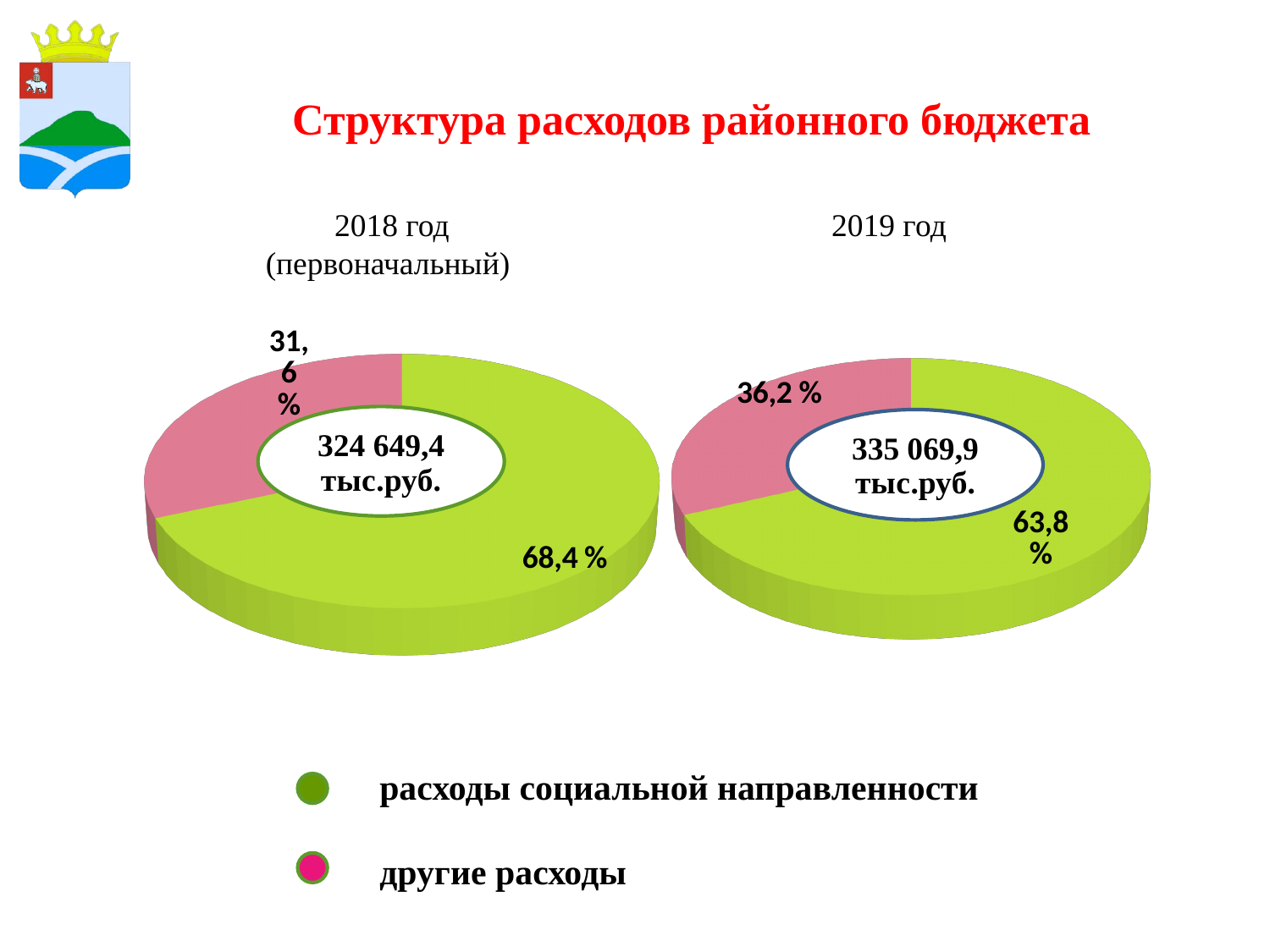
In the 2019 год pie chart, what share is shown for другие расходы? 36,2 % How many slices does each pie chart on the slide have? 2 In the 2018 год (первоначальный) pie chart, what share is shown for другие расходы? 31,6 % What type of chart is used on this slide? Pie chart In the 2019 год pie chart, which category has the largest share? расходы социальной направленности In the 2018 год (первоначальный) pie chart, which category has the smallest share? другие расходы What is the difference in percentage points between the two slices of the 2019 год pie chart? 27,6 Which chart shows a larger share for другие расходы, 2018 год (первоначальный) or 2019 год? 2019 год In the 2019 год pie chart, what share is shown for расходы социальной направленности? 63,8 % In the 2018 год (первоначальный) pie chart, what share is shown for расходы социальной направленности? 68,4 % What total amount is printed in the centre of the 2018 год (первоначальный) pie chart? 324 649,4 тыс.руб. What total amount is printed in the centre of the 2019 год pie chart? 335 069,9 тыс.руб.